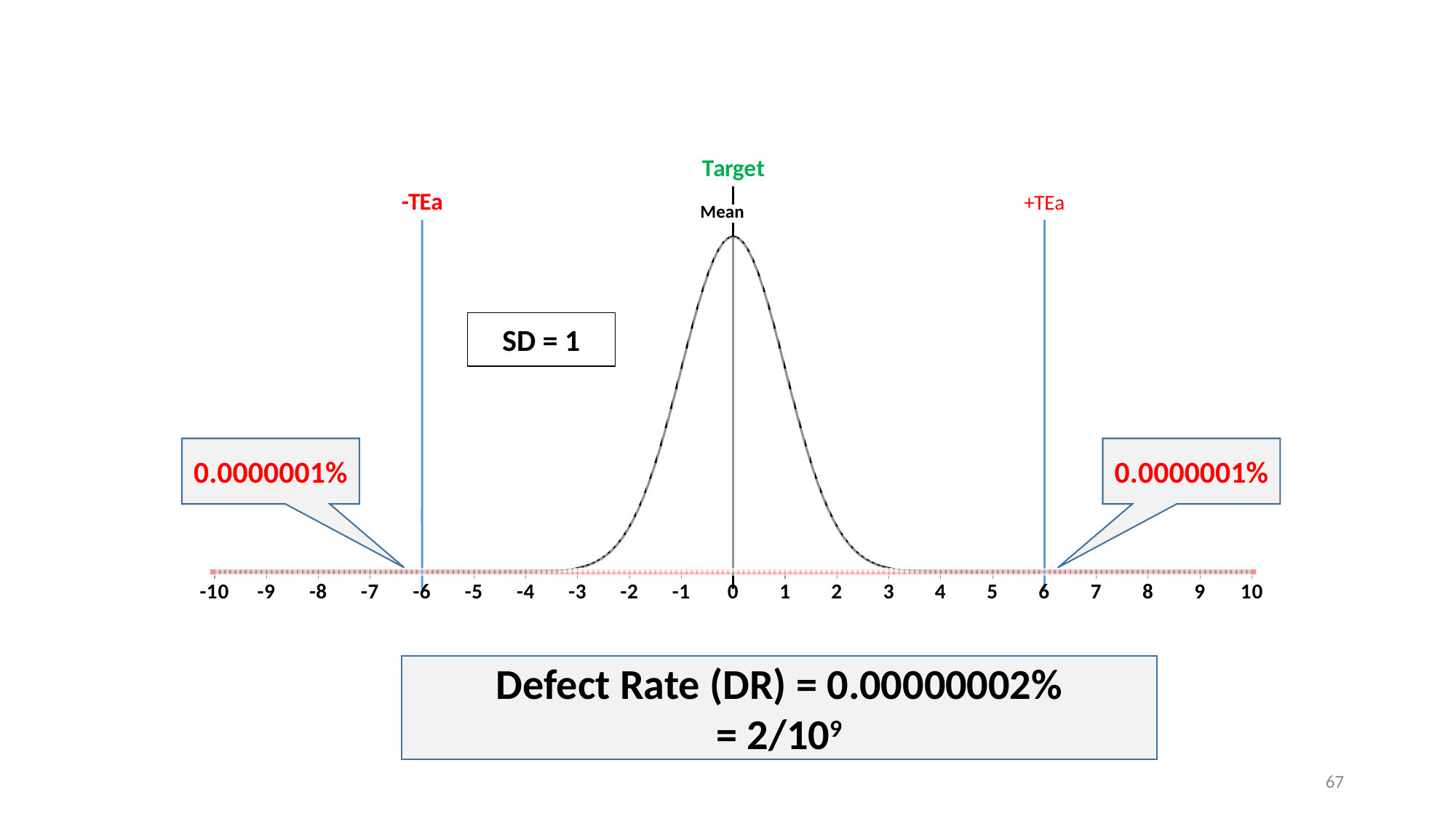
What percentage is shown in the callout beyond the +TEa line? 0.0000001% What is the highest value shown on the x axis? 10 At what x-axis value is the -TEa line located? -6 Does the curve rise or fall as x goes from 0 to 3? fall How many tick labels are shown on the x axis? 21 What is the SD value stated on the chart? 1 What percentage is shown in the callout beyond the -TEa line? 0.0000001% At what x-axis value is the Mean line located? 0 What is the Defect Rate (DR) stated below the chart? 0.00000002% What kind of chart is shown on the slide? line chart At what x-axis value is the +TEa line located? 6 What is the lowest value shown on the x axis? -10